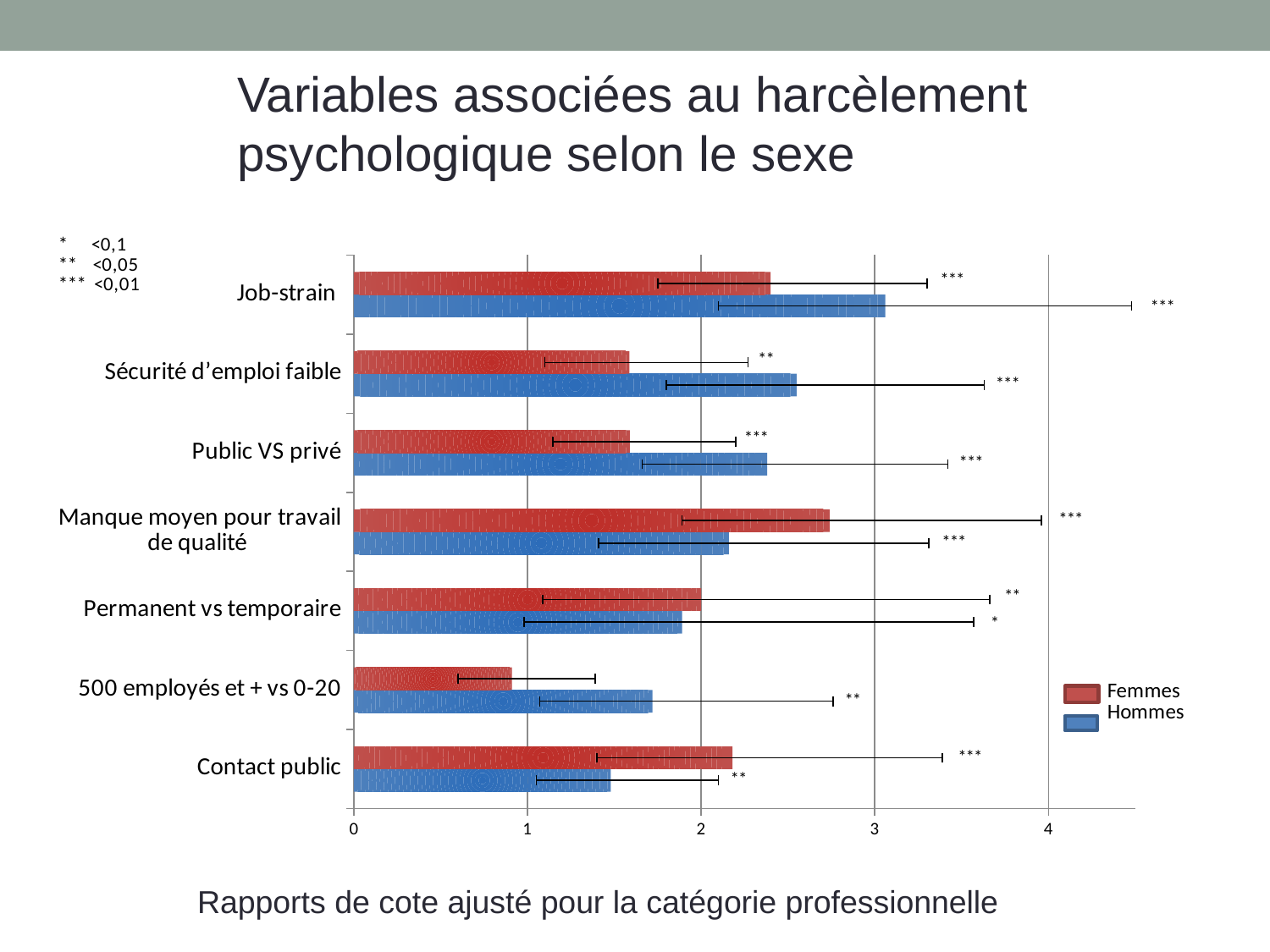
For Job-strain, which series has the larger value, Femmes or Hommes? Hommes Which category has the highest value for the Hommes series? Job-strain Which series is shown in red in the legend? Femmes How many series does the legend list? 2 Which category has the highest value for the Femmes series? Manque moyen pour travail de qualité How many categories are plotted on the y axis? 7 For Manque moyen pour travail de qualité, which series has the larger value, Femmes or Hommes? Femmes For Contact public, which series has the larger value, Femmes or Hommes? Femmes What kind of chart is shown on the slide? bar chart What is the title of the chart? Variables associées au harcèlement psychologique selon le sexe Which category has the lowest value for the Femmes series? 500 employés et + vs 0-20 Is the Femmes value for 500 employés et + vs 0-20 greater or less than 1? less